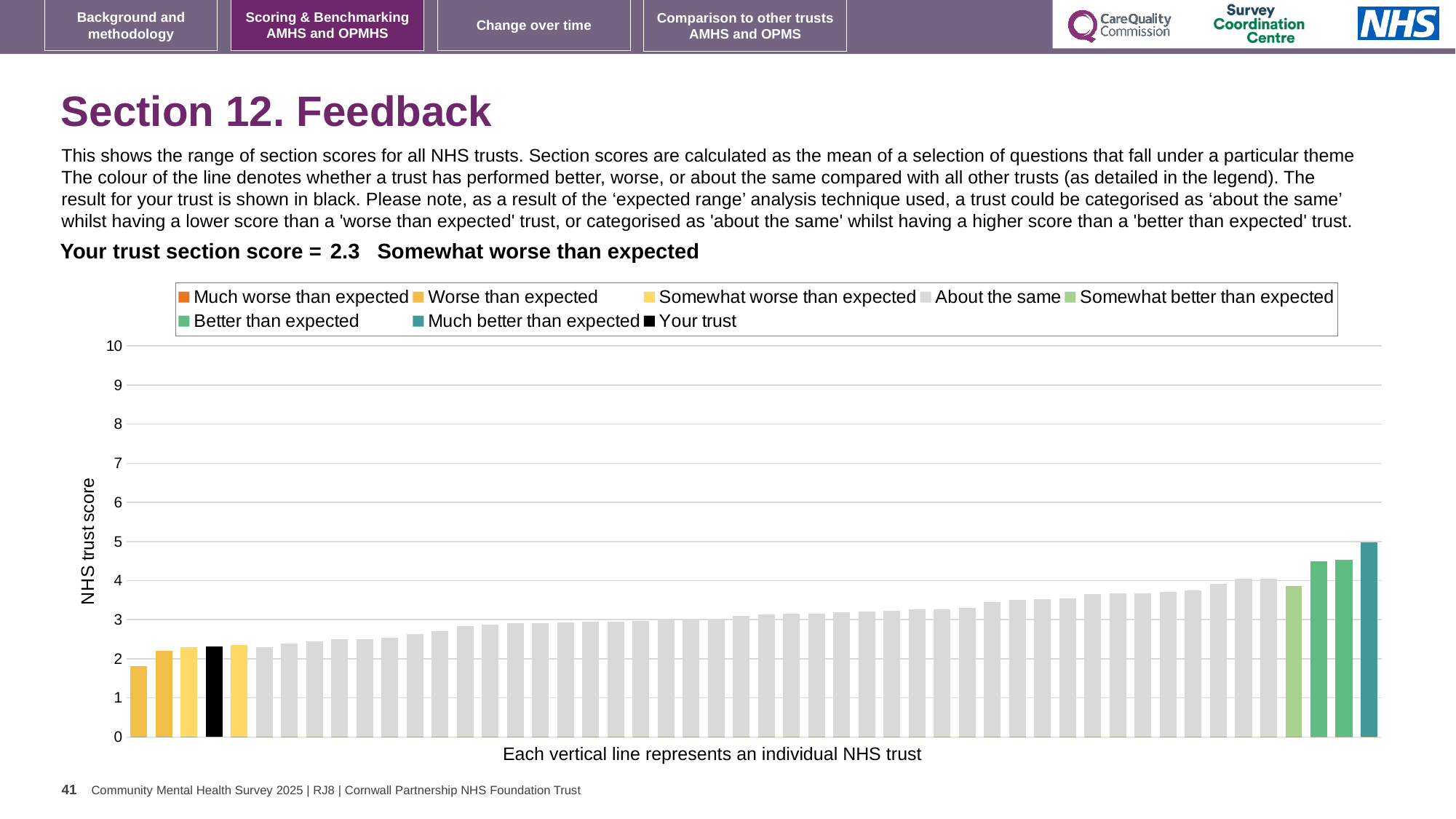
Which category is your trust's section score placed in? Somewhat worse than expected How many entries does the chart legend list? 8 Which legend category does the tallest bar belong to? Much better than expected What is the title of the y axis? NHS trust score Do the bar values rise or fall from left to right along the x axis? rise Is the value for your trust's bar greater or less than 3? less Is the value of the tallest bar greater or less than 4? greater Is the value of the shortest bar greater or less than 2? less What kind of chart is shown on the slide? bar chart What is the section score for your trust? 2.3 What is the highest value shown on the y axis? 10